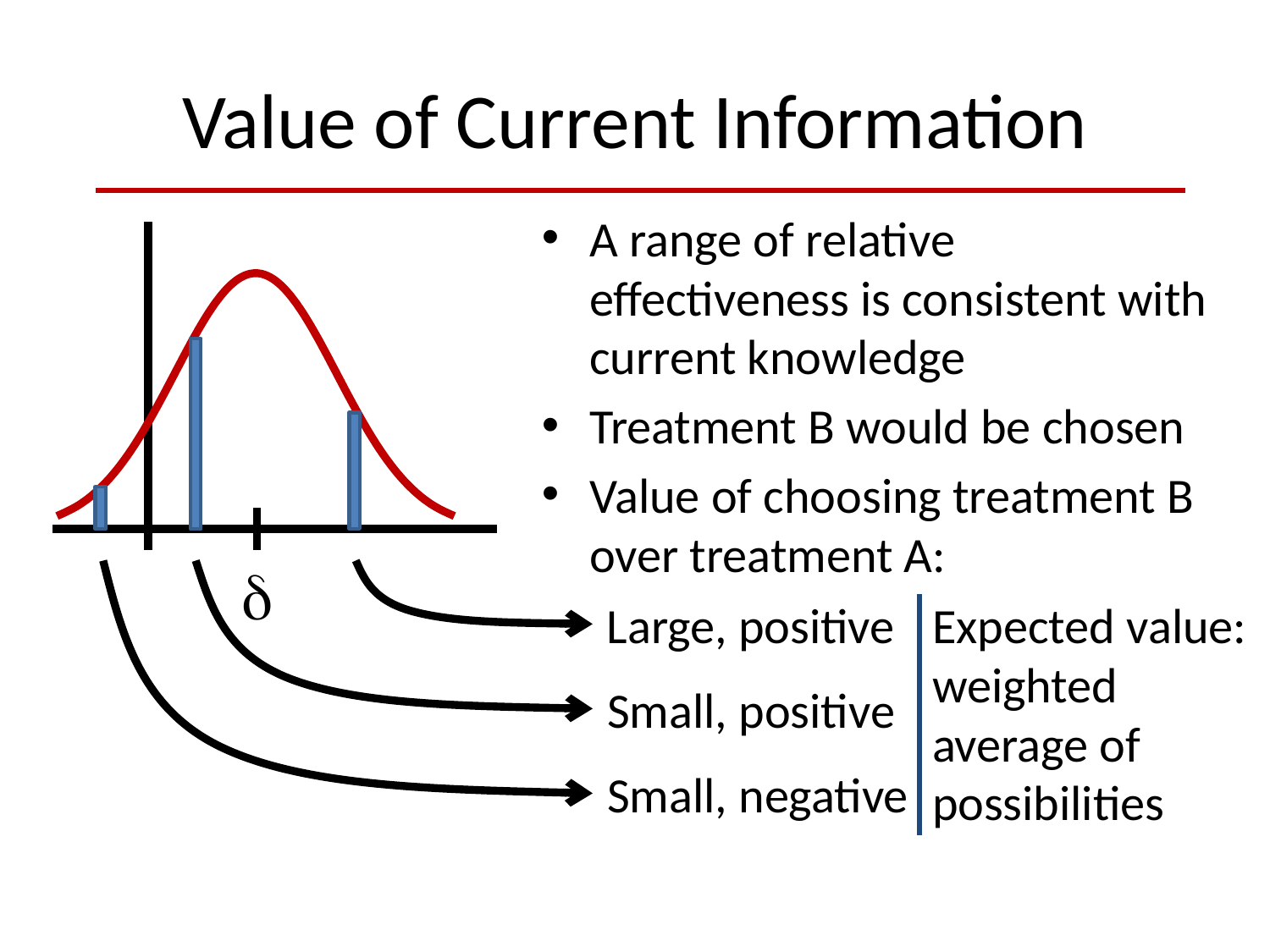
Which outcome label does the arrow from the leftmost bar point to? Small, negative Which of the three blue bars under the curve is the tallest? the middle bar Which of the three blue bars under the curve is the shortest? the leftmost bar How many blue bars are drawn under the red curve in the diagram? 3 Which outcome label does the arrow from the middle bar point to? Small, positive Is the middle blue bar taller or shorter than the rightmost blue bar? taller Is the rightmost blue bar taller or shorter than the leftmost blue bar? taller What symbol labels the horizontal axis of the diagram? δ What colour is the bell-shaped curve in the diagram? red Which outcome label does the arrow from the rightmost bar point to? Large, positive